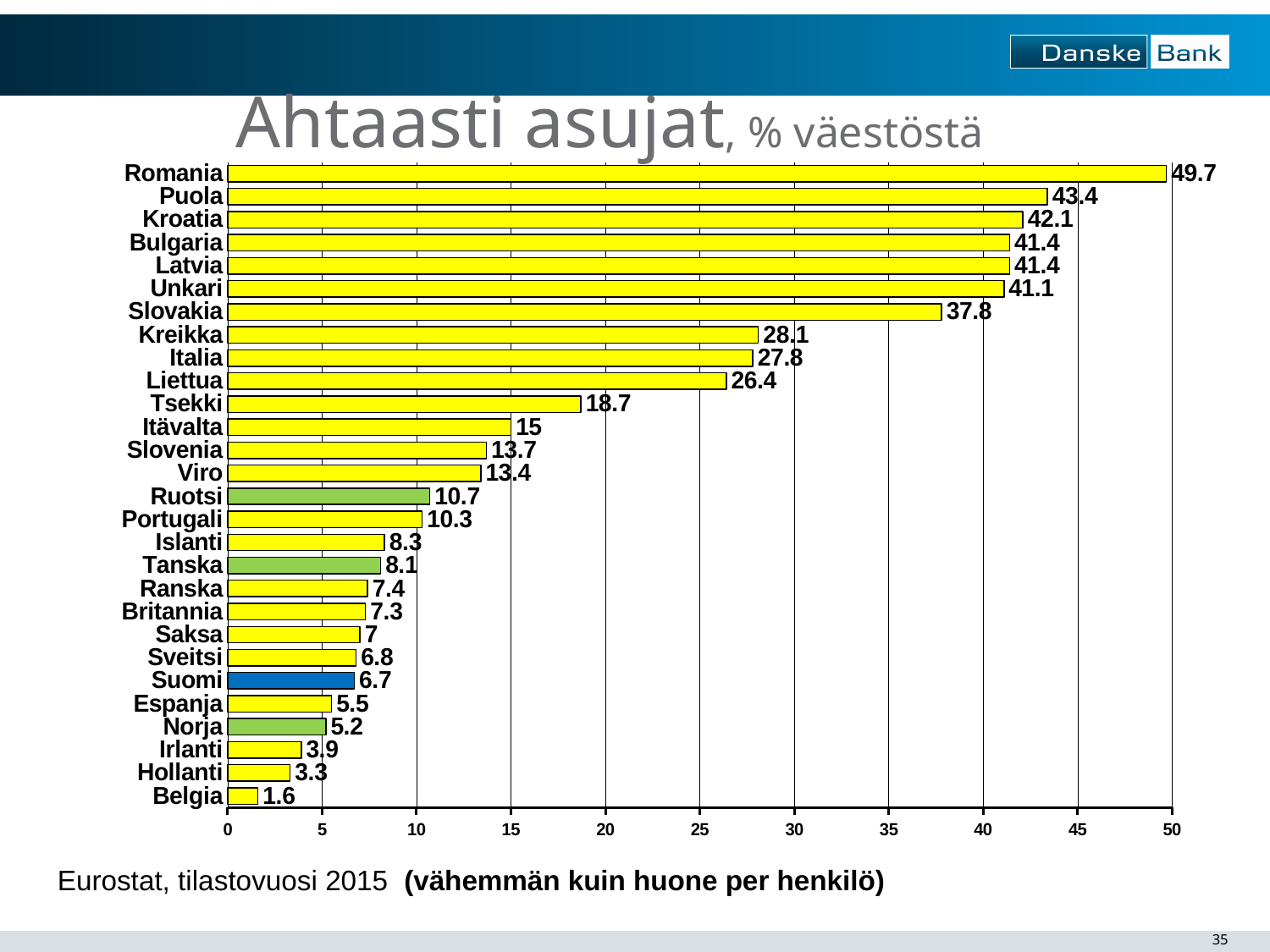
What is the value for Tsekki? 18.7 How many countries are shown in the chart? 28 What is the value for Slovakia? 37.8 What is the value for Suomi? 6.7 Which country has the highest value? Romania Which is larger, the value for Kreikka or the value for Liettua? Kreikka Is the value for Itävalta greater or less than 10? greater What is the title of the chart? Ahtaasti asujat, % väestöstä Which country has the lowest value? Belgia What is the difference between the values for Ruotsi and Suomi? 4 What is the difference between the values for Romania and Puola? 6.3 What kind of chart is shown on the slide? bar chart